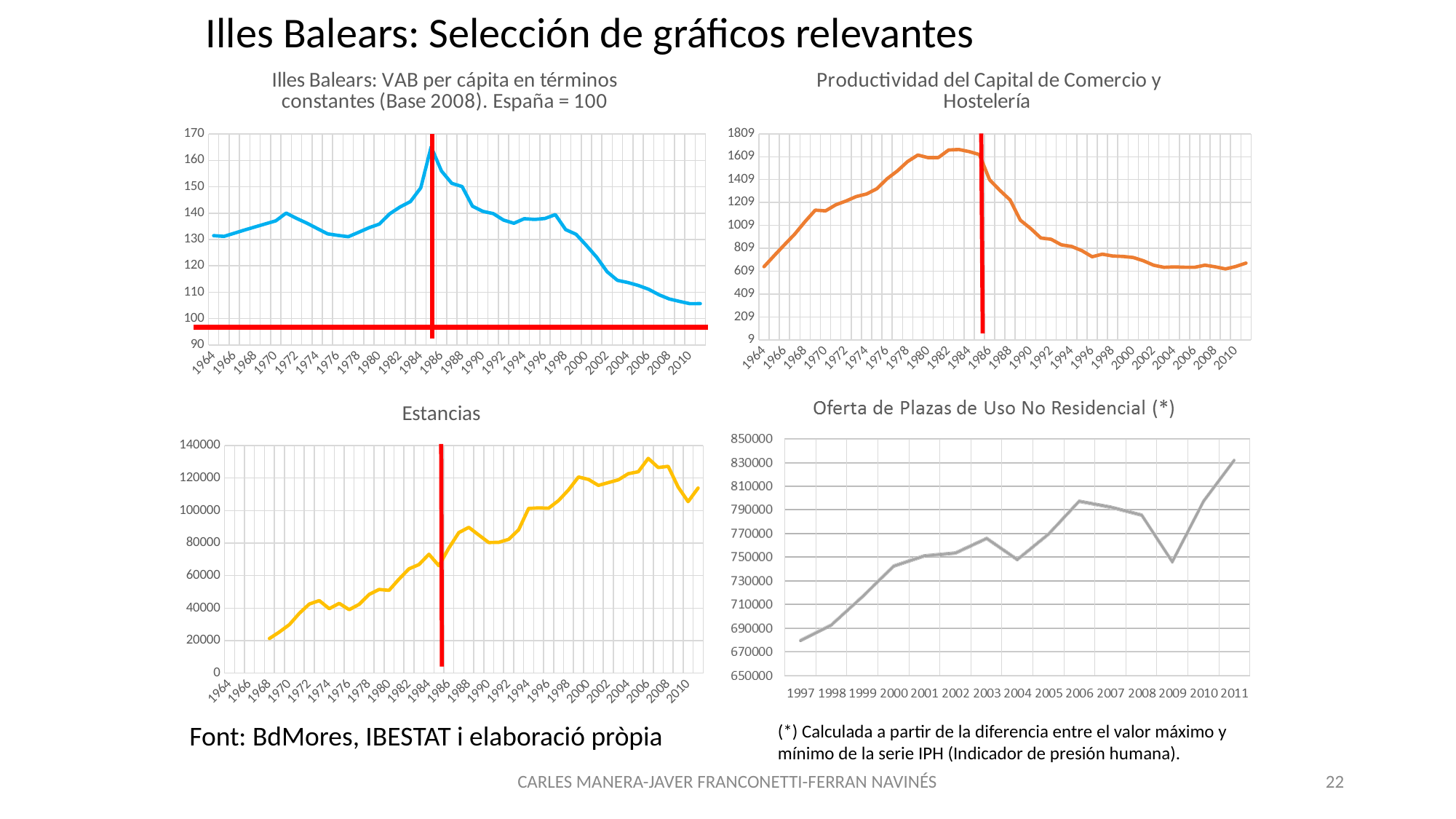
How many charts are shown on the slide? 4 In the 'Oferta de Plazas de Uso No Residencial (*)' chart, which is larger, the value for 2006 or the value for 2009? 2006 In the 'Estancias' chart, is the value for 1968 greater or less than 40000? less In the 'Illes Balears: VAB per cápita' chart (top left), do the values rise or fall between 1986 and 2010? fall In the 'Productividad del Capital de Comercio y Hostelería' chart, is the value for 2010 greater or less than 809? less What kind of chart is the 'Estancias' chart? line chart In the 'Oferta de Plazas de Uso No Residencial (*)' chart, which year has the lowest value? 1997 In the 'Oferta de Plazas de Uso No Residencial (*)' chart, is the value for 1997 greater or less than 690000? less In the 'Oferta de Plazas de Uso No Residencial (*)' chart, which year has the highest value? 2011 In the 'Oferta de Plazas de Uso No Residencial (*)' chart, how many years are plotted on the x axis? 15